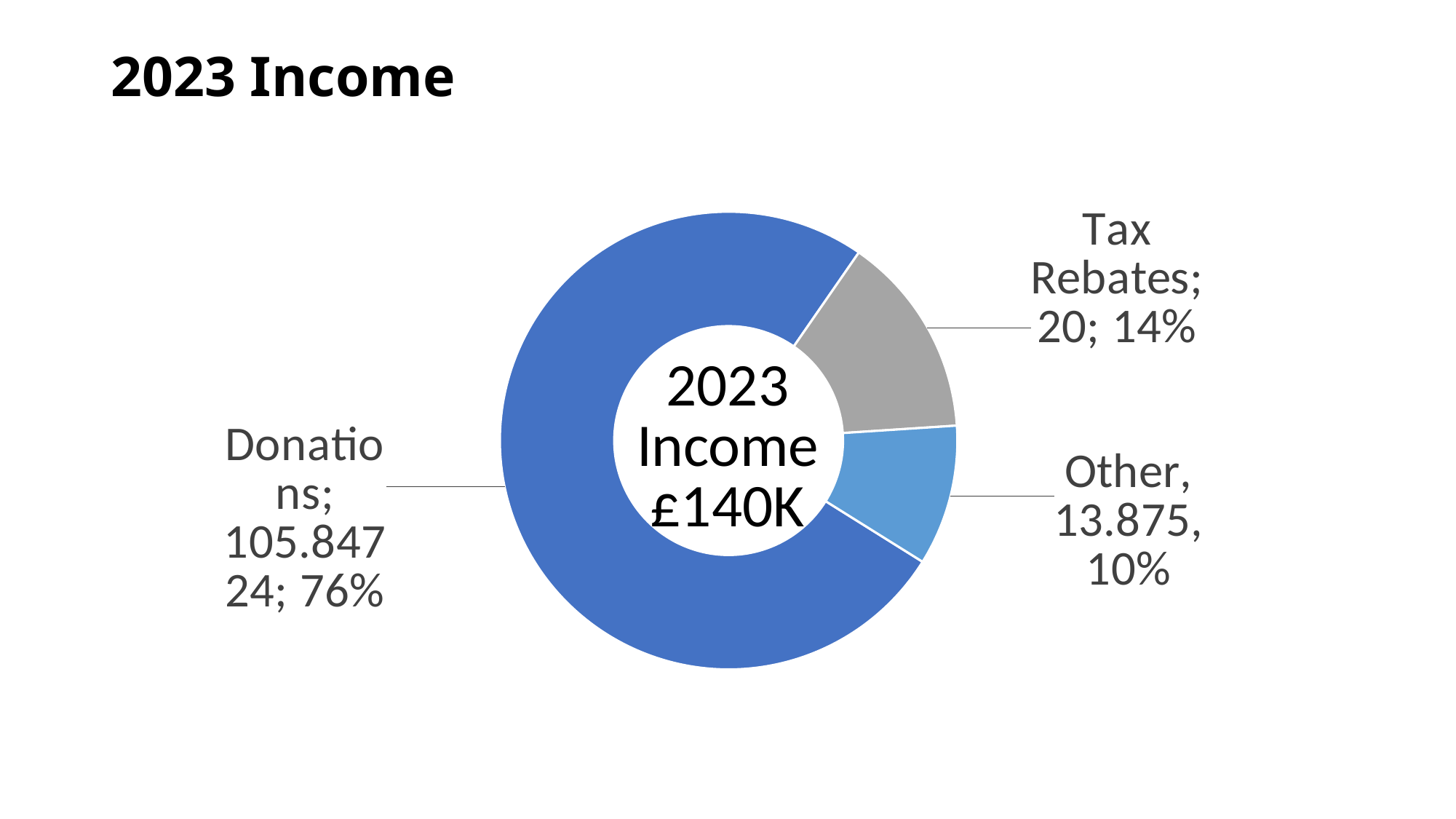
What share of 2023 income comes from Donations? 76% Which category is the smallest slice of the chart? Other What share of 2023 income comes from Other? 10% How many slices does the doughnut chart have? 3 What kind of chart is shown on the slide? Doughnut chart What is the value shown for Other? 13.875 What text is shown in the centre of the doughnut chart? 2023 Income £140K What share of 2023 income comes from Tax Rebates? 14% What is the value shown for Tax Rebates? 20 What is the difference between the values for Tax Rebates and Other? 6.125 Which is larger, Tax Rebates or Other? Tax Rebates Which category is the largest slice of the chart? Donations